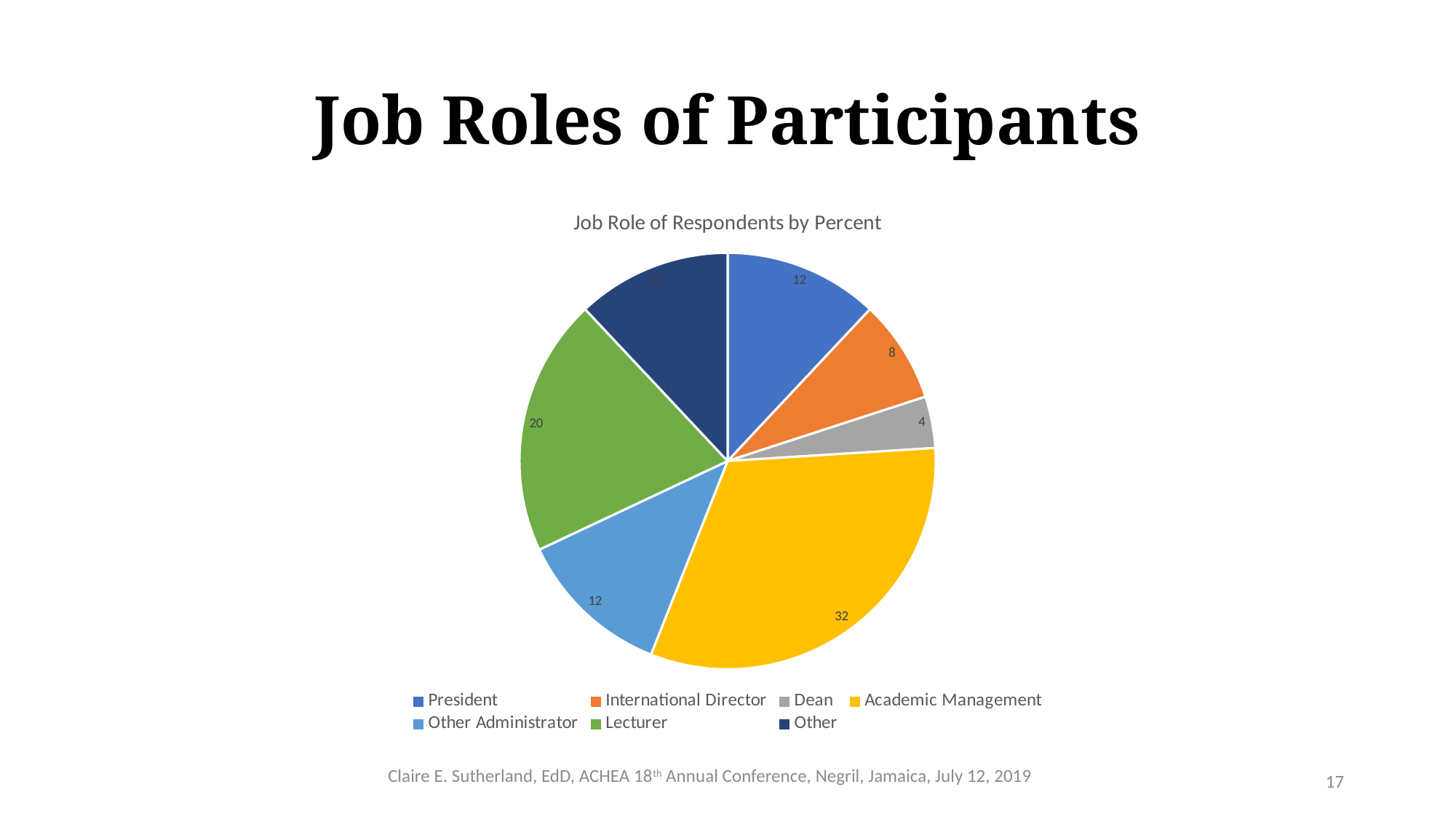
How many job role categories does the legend list? 7 What is the value shown for Dean in the pie chart? 4 What is the value shown for Academic Management in the pie chart? 32 Which job role has the largest slice of the pie chart? Academic Management What kind of chart is shown on the slide? Pie chart Which is larger, the value for Lecturer or the value for International Director? Lecturer What is the value shown for Lecturer in the pie chart? 20 What is the difference between the values for Academic Management and Lecturer? 12 What is the title of the chart? Job Role of Respondents by Percent What is the value shown for President in the pie chart? 12 What is the value shown for International Director in the pie chart? 8 Which job role has the smallest slice of the pie chart? Dean